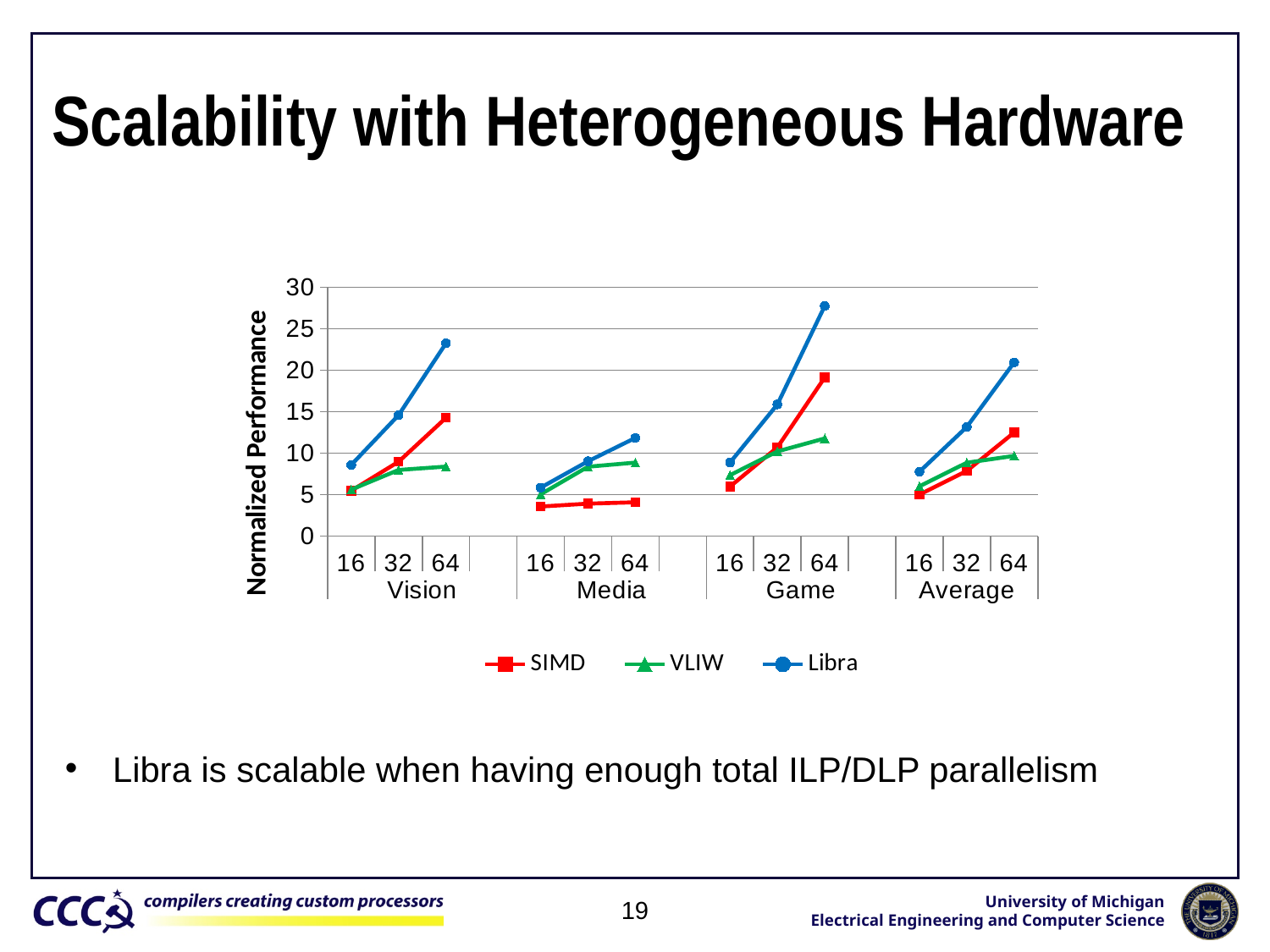
Which series has the highest value at Game 64? Libra How many series does the legend list? 3 Which series is drawn in blue with circle markers? Libra Does the Libra series rise or fall from 16 to 64 in the Vision group? rise Is the value for SIMD at Media 64 greater or less than 5? less Is the value for Libra at Game 64 greater or less than 25? greater What is the label of the y axis? Normalized Performance How many benchmark groups are shown along the x axis? 4 Which series has the lowest values in the Media group? SIMD Is the value for Libra at Average 64 greater or less than 20? greater What kind of chart is shown on the slide? line chart At Media 64, which is larger, SIMD or VLIW? VLIW